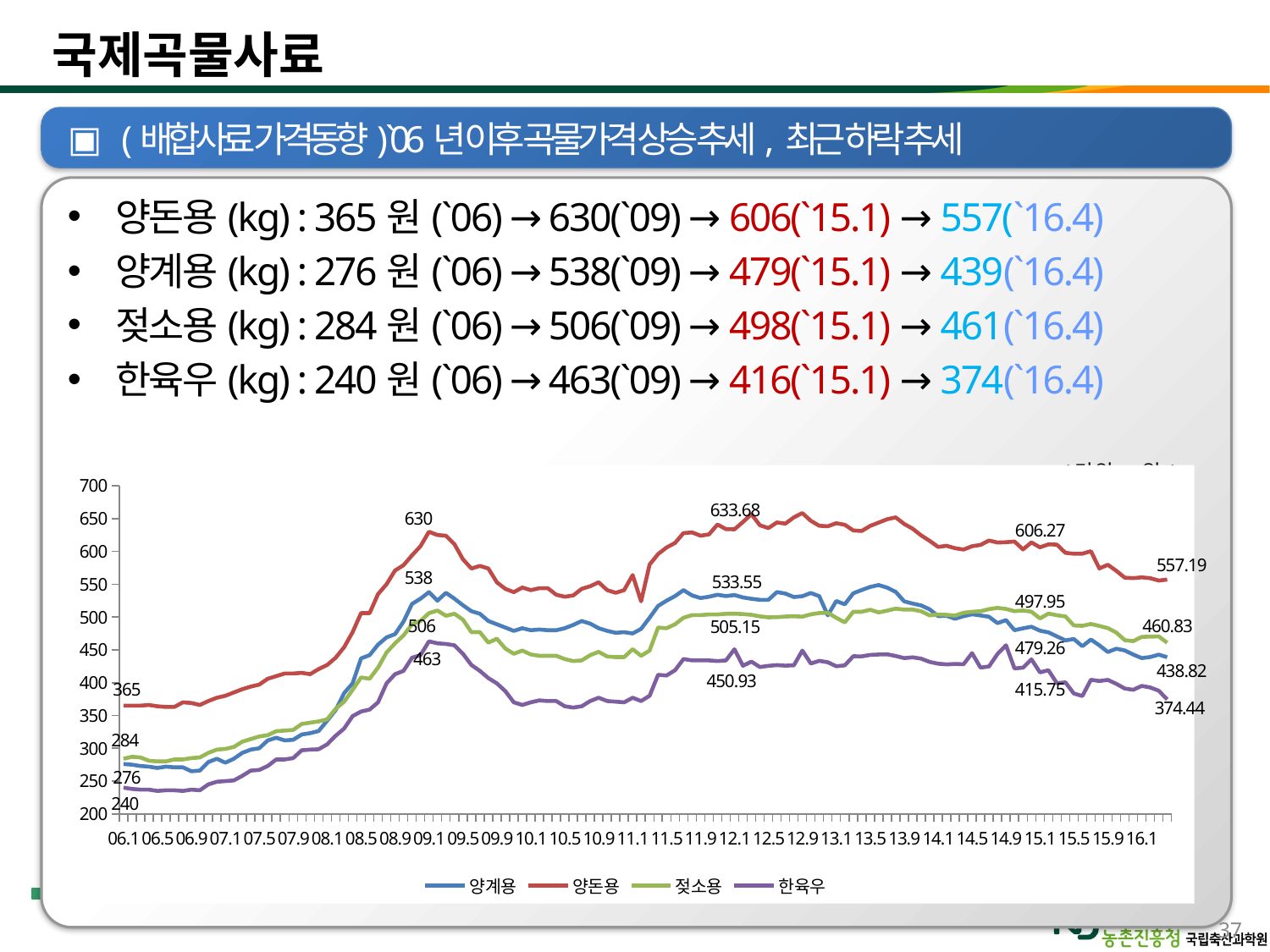
What kind of chart is shown on the slide? line chart What is the difference between the 양돈용 value labelled 630 and the 양계용 value labelled 538 at 09.1? 92 What is the labelled peak value of the 양돈용 series near 12.1? 633.68 Which series has the lowest values across the chart? 한육우 Is the 한육우 value at 06.1 greater or less than 250? less What is the final labelled value of the 양돈용 series at the right end of the chart? 557.19 What colour is the 양돈용 line in the chart? red What is the labelled value of the 한육우 series at the right end of the chart? 374.44 Which is larger at the right end of the chart: the 젖소용 value (460.83) or the 양계용 value (438.82)? 젖소용 (460.83) Which series has the highest values across the chart? 양돈용 What is the labelled value of the 젖소용 series near 15.1? 497.95 How many series does the chart legend list? 4